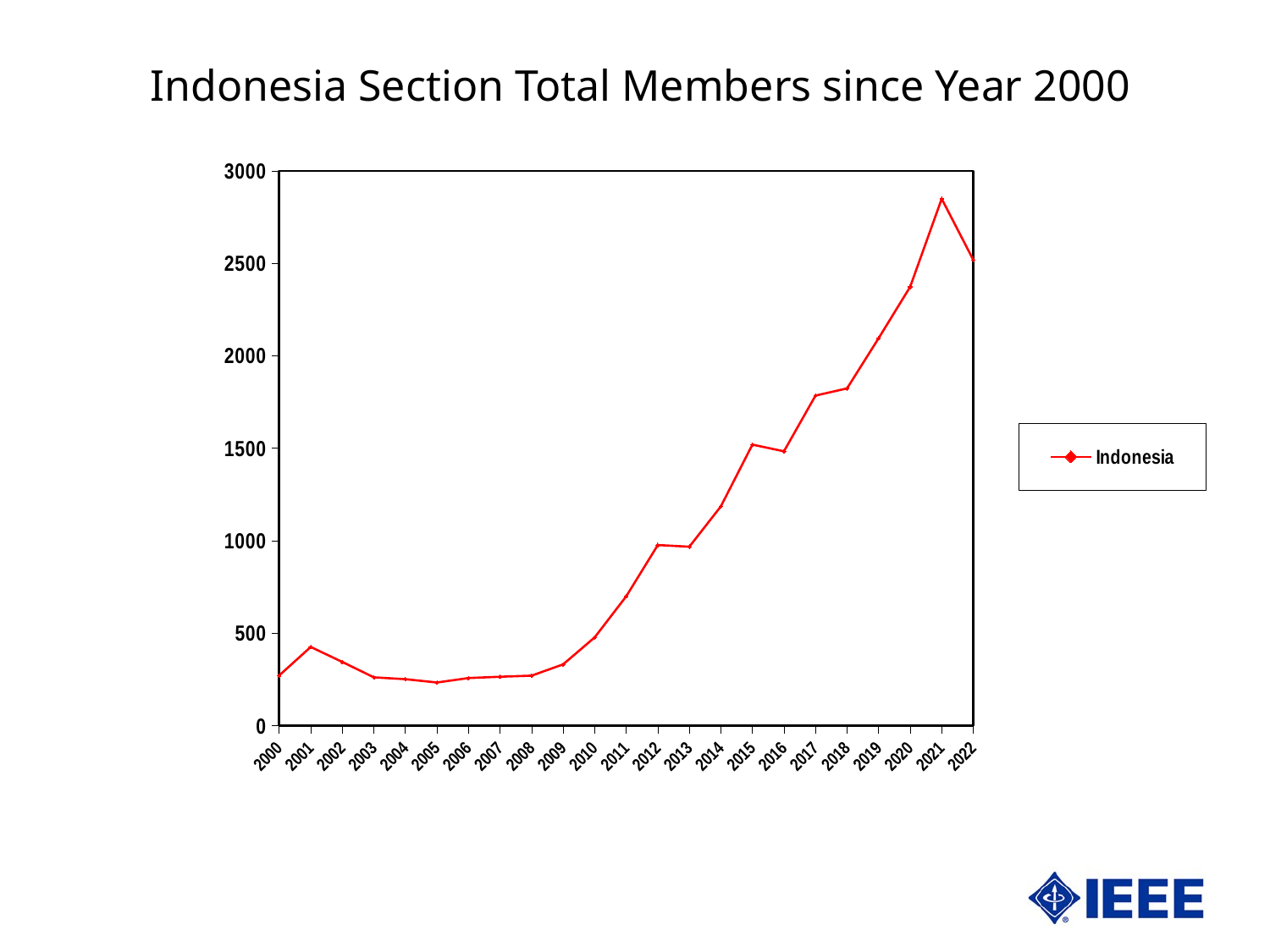
In which year is the number of members highest? 2021 In which year is the number of members lowest? 2005 How many years are plotted along the x axis? 23 Overall, do the values rise or fall from 2000 to 2022? rise Which year has more members, 2021 or 2022? 2021 Is the value for 2014 greater or less than 1000? greater What is the title of the chart? Indonesia Section Total Members since Year 2000 Is the value for 2001 greater or less than 500? less What kind of chart is shown on the slide? line chart Is the value for 2020 greater or less than 2500? less How many series does the legend list? 1